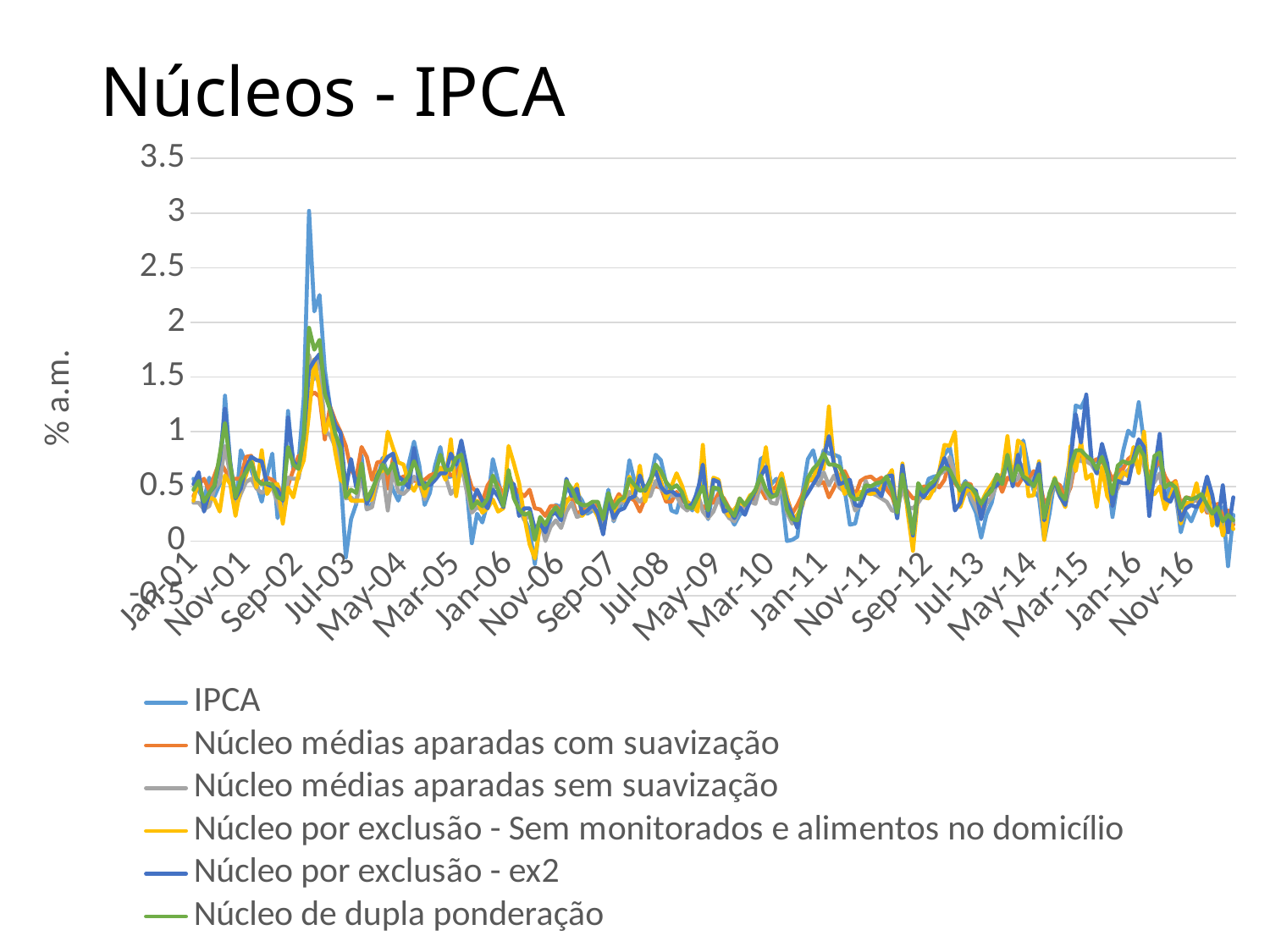
What is the first label shown on the horizontal axis? Jan-01 Is the highest value reached by the IPCA series greater or less than 3.5? less What is the label on the vertical axis? % a.m. What kind of chart is shown on the slide? line chart Is the highest value reached by the IPCA series greater or less than 2.5? greater Which series reaches the highest value on the chart? IPCA What is the last label shown on the horizontal axis? Nov-16 What is the highest tick value shown on the vertical axis? 3.5 Is the highest value reached by the Núcleo médias aparadas com suavização series greater or less than 2? less How many series does the legend list? 6 What is the title of the chart? Núcleos - IPCA